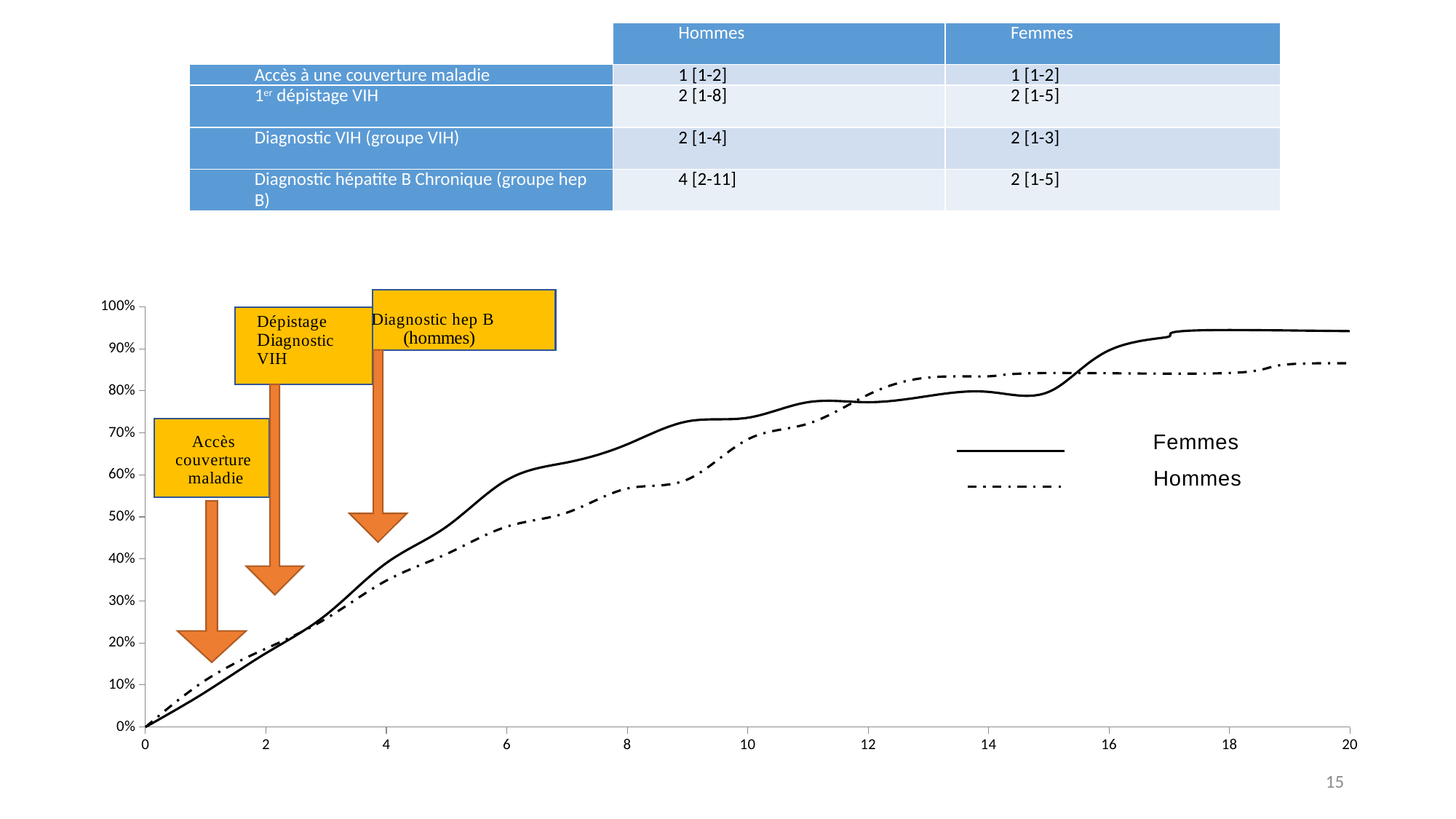
What is the label of the orange annotation box whose arrow points to the curves near x = 1? Accès couverture maladie Is the value of the Hommes series at x = 20 greater or less than 90%? less How many series does the chart's legend list? 2 At x = 12, which series has the higher value, Femmes or Hommes? Hommes Is the value of the Hommes series at x = 14 greater or less than 80%? greater Is the value of the Femmes series at x = 20 greater or less than 90%? greater At x = 8, which series has the higher value, Femmes or Hommes? Femmes What kind of chart is shown on the slide? line chart Which series is drawn with a dash-dot line in the chart? Hommes At x = 20, which series has the higher value, Femmes or Hommes? Femmes Do the values of the Femmes series rise or fall as the x axis increases from 0 to 20? rise